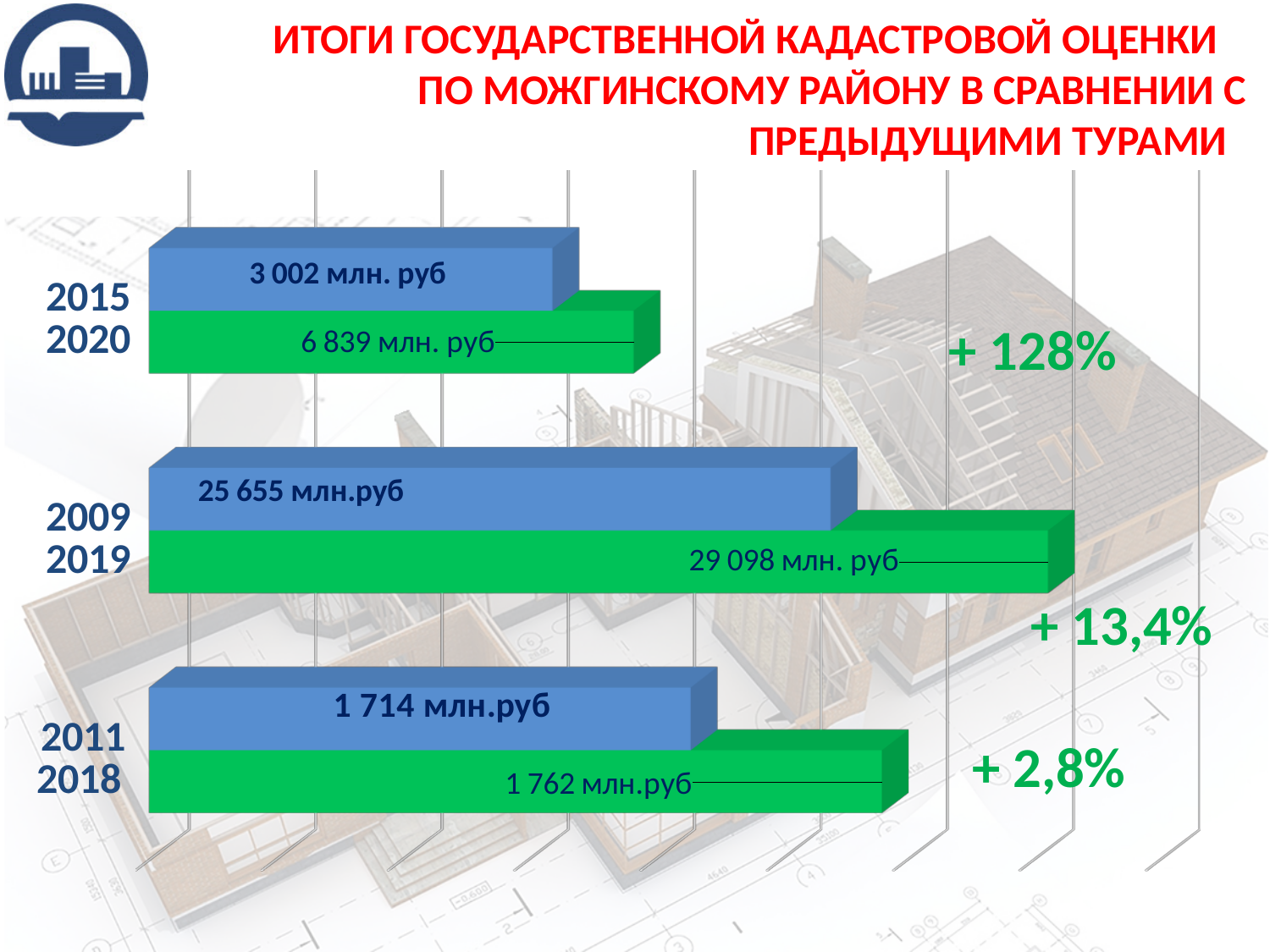
What is the value shown for 2020 on the chart? 6 839 млн. руб What is the value shown for 2015 on the chart? 3 002 млн. руб What is the value shown for 2009 on the chart? 25 655 млн.руб What is the difference between the values for 2019 and 2009? 3 443 млн. руб What is the difference between the values for 2020 and 2015? 3 837 млн. руб Which year has the lowest value on the chart? 2011 Which is larger, the value for 2018 or the value for 2011? 2018 What type of chart is shown on the slide? Bar chart What percentage change is shown next to the 2009/2019 pair of bars? + 13,4% What is the value shown for 2019 on the chart? 29 098 млн. руб What is the value shown for 2018 on the chart? 1 762 млн.руб Which year has the highest value on the chart? 2019